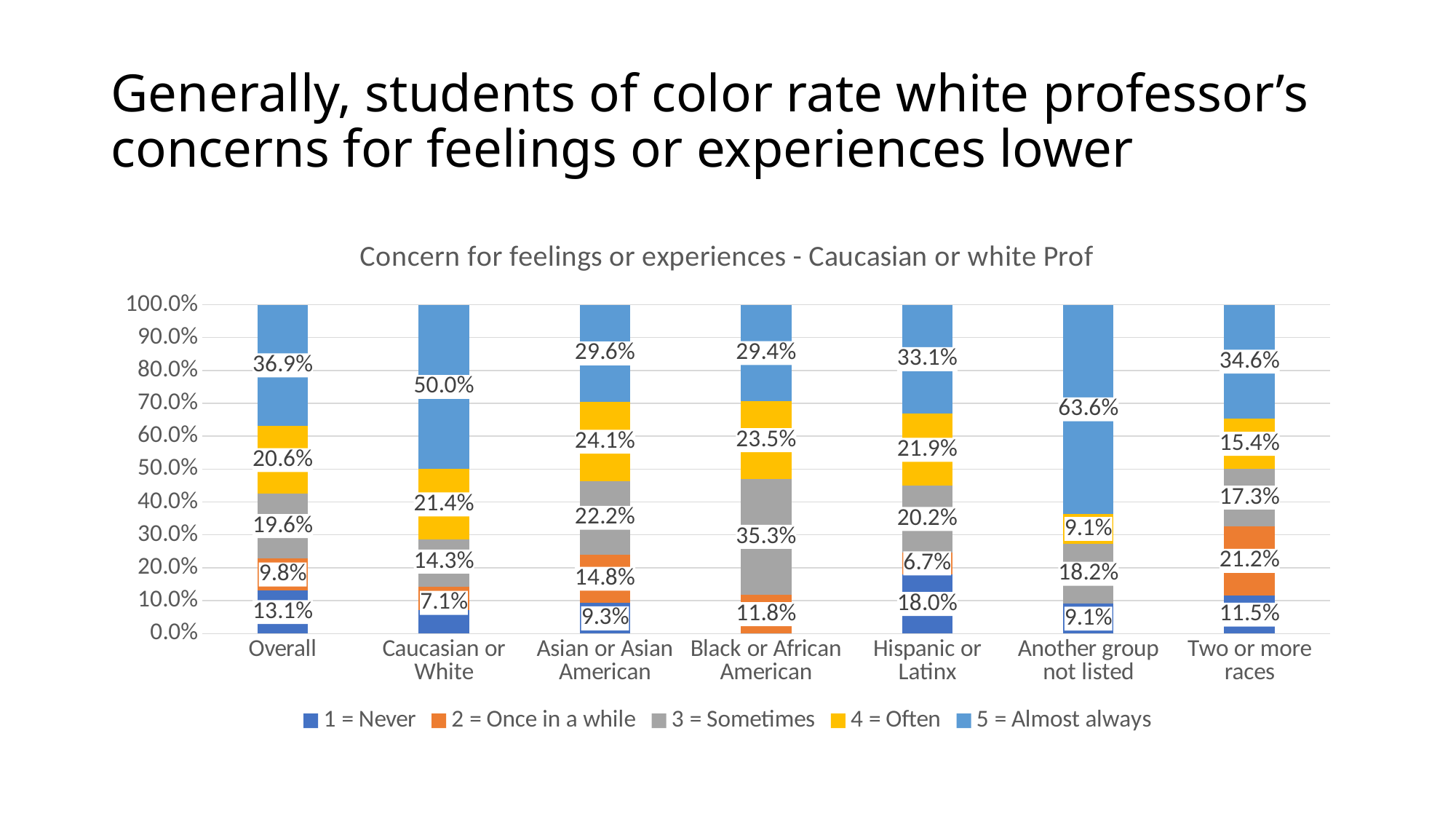
What is the '5 = Almost always' value for 'Another group not listed'? 63.6% What is the '1 = Never' value for 'Hispanic or Latinx'? 18.0% How many series does the chart's legend list? 5 What is the title of the chart? Concern for feelings or experiences - Caucasian or white Prof How many categories (groups) are shown along the x axis of the chart? 7 What type of chart is shown on the slide? Stacked bar chart Which category has the highest '3 = Sometimes' share? Black or African American Which has the larger '4 = Often' share: 'Asian or Asian American' or 'Hispanic or Latinx'? Asian or Asian American Which category has the highest '5 = Almost always' share? Another group not listed What is the '3 = Sometimes' value for 'Caucasian or White'? 14.3% How much higher is the '5 = Almost always' share for 'Caucasian or White' than for 'Overall'? 13.1 percentage points What is the '2 = Once in a while' value for 'Two or more races'? 21.2%